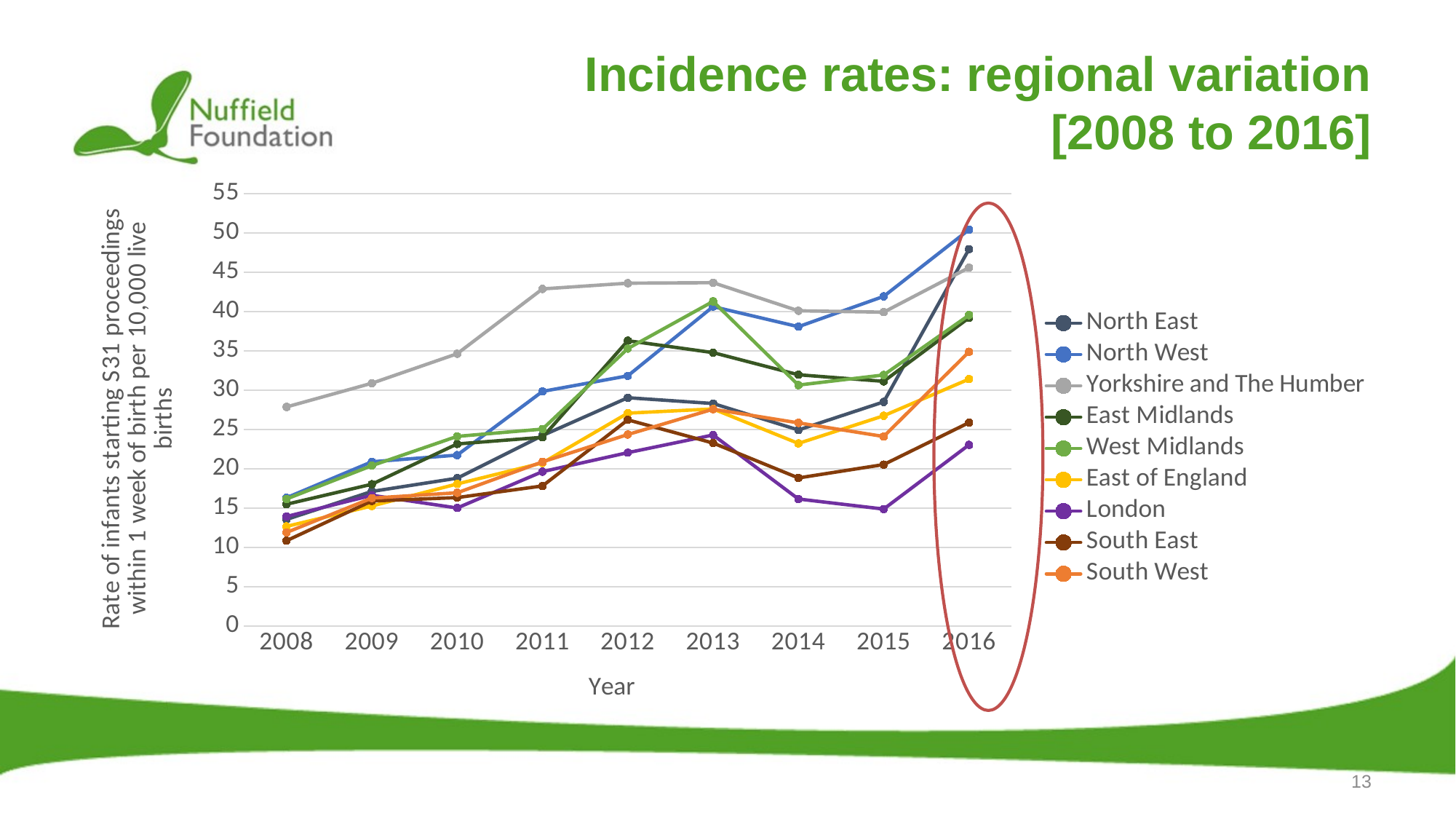
Which region has the highest rate in 2008? Yorkshire and The Humber Which year on the x axis is circled in red? 2016 How many years are shown along the x axis? 9 What kind of chart is shown on the slide? line chart In 2013, which is larger: Yorkshire and The Humber or North West? Yorkshire and The Humber Does the rate for Yorkshire and The Humber rise or fall from 2008 to 2013? rise Is the value for South East in 2008 greater or less than 15? less Is the value for Yorkshire and The Humber in 2011 greater or less than 40? greater How many series does the legend list? 9 Is the value for London in 2014 greater or less than 20? less Which region has the lowest rate in 2016? London Which region has the lowest rate in 2014? London